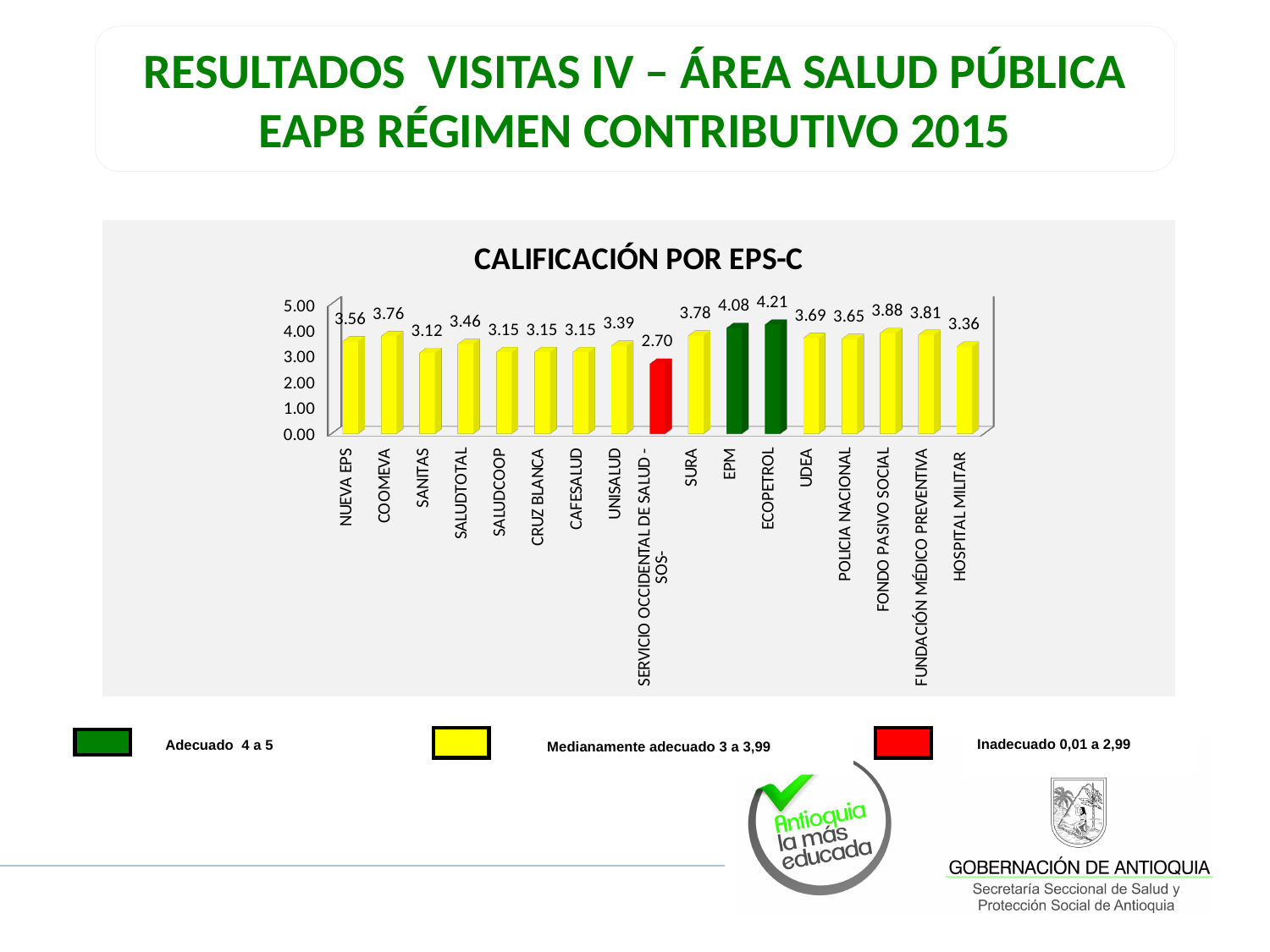
What kind of chart is shown on the slide? Bar chart Which EPS has the lowest calificación in the chart? SERVICIO OCCIDENTAL DE SALUD -SOS- What is the difference between the values for SURA and HOSPITAL MILITAR? 0.42 Which has a higher value, COOMEVA or UDEA? COOMEVA What is the value for ECOPETROL in the CALIFICACIÓN POR EPS-C chart? 4.21 How many EPS categories are shown in the chart? 17 Which EPS has the highest calificación in the chart? ECOPETROL What is the difference between the values for ECOPETROL and EPM? 0.13 What is the value for FONDO PASIVO SOCIAL? 3.88 Is the value for SERVICIO OCCIDENTAL DE SALUD -SOS- greater or less than 3.00? less What is the value for SANITAS in the chart? 3.12 What colour are the bars for EPM and ECOPETROL? Green